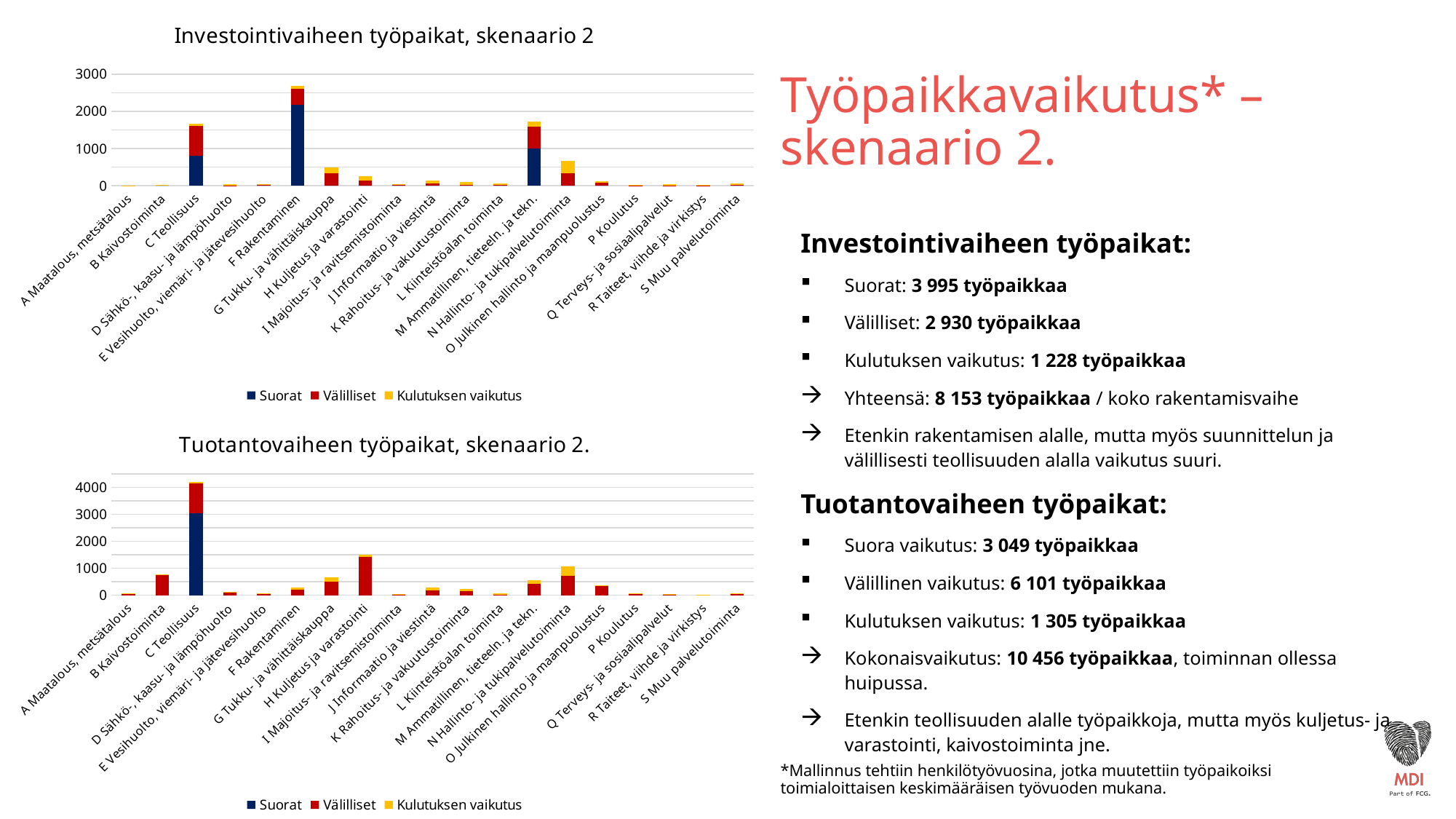
In the bottom chart "Tuotantovaiheen työpaikat, skenaario 2.", is the total bar for C Teollisuus greater or less than 3000? greater How many categories are shown on the x axis of the bottom chart "Tuotantovaiheen työpaikat, skenaario 2."? 19 What kind of chart is the top chart titled "Investointivaiheen työpaikat, skenaario 2"? stacked bar chart In the top chart "Investointivaiheen työpaikat, skenaario 2", which bar is taller: F Rakentaminen or C Teollisuus? F Rakentaminen In the bottom chart "Tuotantovaiheen työpaikat, skenaario 2.", is the total bar for B Kaivostoiminta greater or less than 1000? less How many series does the legend of the top chart "Investointivaiheen työpaikat, skenaario 2" list? 3 What are the three legend entries of the bottom chart "Tuotantovaiheen työpaikat, skenaario 2."? Suorat, Välilliset, Kulutuksen vaikutus In the top chart "Investointivaiheen työpaikat, skenaario 2", which category has the tallest bar? F Rakentaminen In the bottom chart "Tuotantovaiheen työpaikat, skenaario 2.", which category has the tallest bar? C Teollisuus In the top chart "Investointivaiheen työpaikat, skenaario 2", is the total bar for F Rakentaminen greater or less than 2000? greater